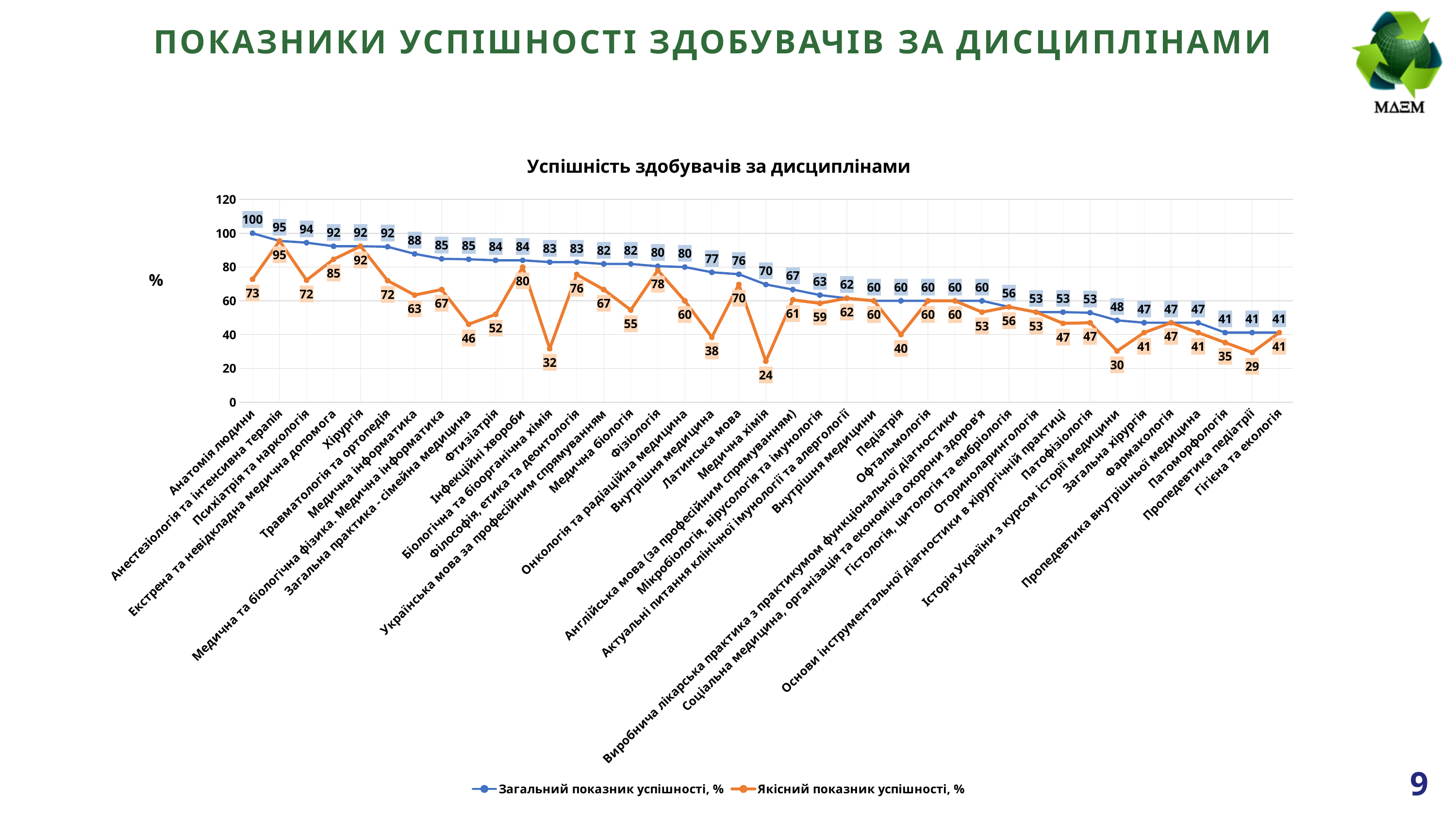
What is the value of 'Якісний показник успішності, %' for 'Біологічна та біоорганічна хімія'? 32 What is the value of 'Загальний показник успішності, %' for 'Анатомія людини'? 100 What is the value of 'Якісний показник успішності, %' for 'Медична хімія'? 24 What kind of chart is shown on the slide? line chart What is the title of the chart? Успішність здобувачів за дисциплінами What is the difference between 'Загальний показник успішності, %' and 'Якісний показник успішності, %' for 'Внутрішня медицина'? 39 How many series does the legend of the chart list? 2 Which discipline has the lowest value of 'Якісний показник успішності, %'? Медична хімія Does the 'Загальний показник успішності, %' line generally rise or fall from left to right along the x axis? fall What is the difference between 'Загальний показник успішності, %' and 'Якісний показник успішності, %' for 'Анатомія людини'? 27 Which discipline has the highest value of 'Загальний показник успішності, %'? Анатомія людини Which has the higher 'Якісний показник успішності, %': 'Хірургія' or 'Фтизіатрія'? Хірургія